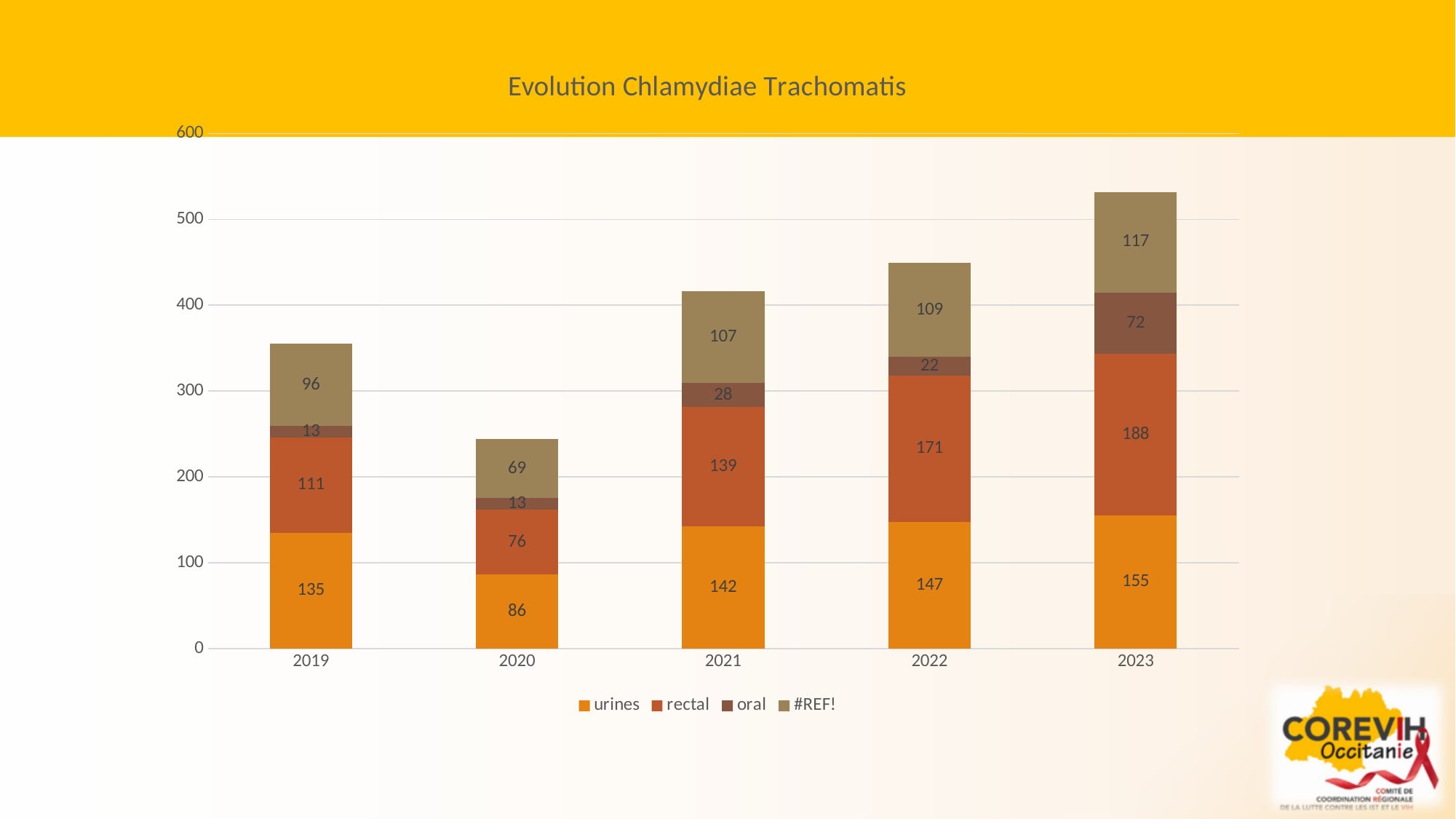
What is the difference between the rectal values for 2023 and 2022? 17 What is the total of the stacked bar for 2023? 532 Which is larger, the oral value in 2021 or in 2023? 2023 How many years are shown on the x axis? 5 What is the value for rectal in 2023? 188 What is the value for the #REF! series in 2019? 96 Which year has the lowest value for rectal? 2020 What is the value for oral in 2022? 22 How many series does the legend list? 4 Which year has the highest value for urines? 2023 What is the total of the stacked bar for 2020? 244 What is the value for urines in 2021? 142